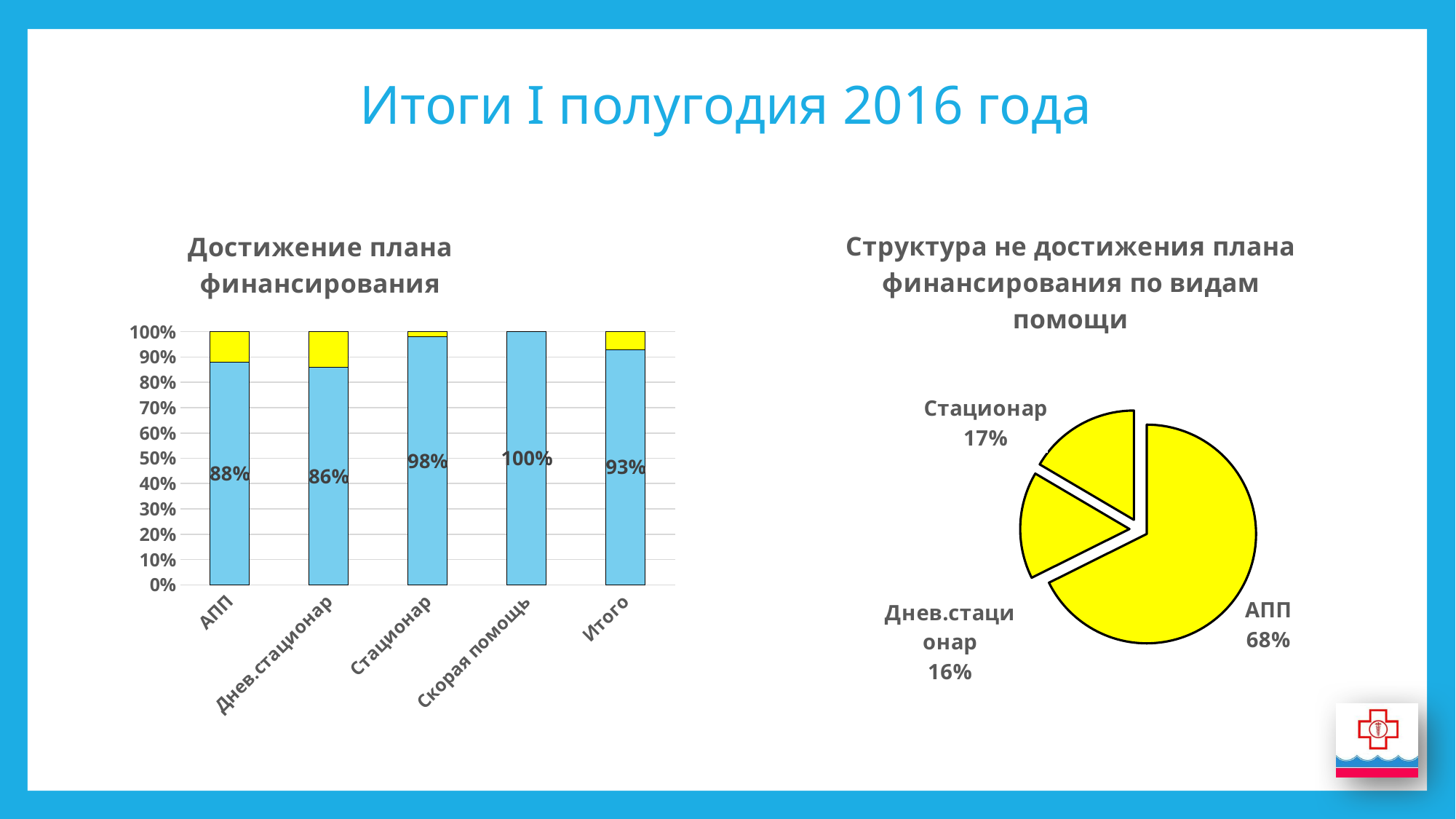
In the chart 'Достижение плана финансирования', what is the value for АПП? 88% In the chart 'Достижение плана финансирования', which category has the lowest value? Днев.стационар In the chart 'Достижение плана финансирования', what is the value for Днев.стационар? 86% In the chart 'Достижение плана финансирования', which category has the highest value? Скорая помощь In the chart 'Достижение плана финансирования', what is the value for Скорая помощь? 100% In the pie chart 'Структура не достижения плана финансирования по видам помощи', how many slices are there? 3 In the pie chart 'Структура не достижения плана финансирования по видам помощи', what share does АПП have? 68% What kind of chart is 'Достижение плана финансирования'? Bar chart In the chart 'Достижение плана финансирования', what is the difference between the values for Стационар and АПП? 10% In the pie chart 'Структура не достижения плана финансирования по видам помощи', which slice is the largest? АПП In the pie chart 'Структура не достижения плана финансирования по видам помощи', what share does Днев.стационар have? 16% In the chart 'Достижение плана финансирования', how many categories are shown on the x axis? 5